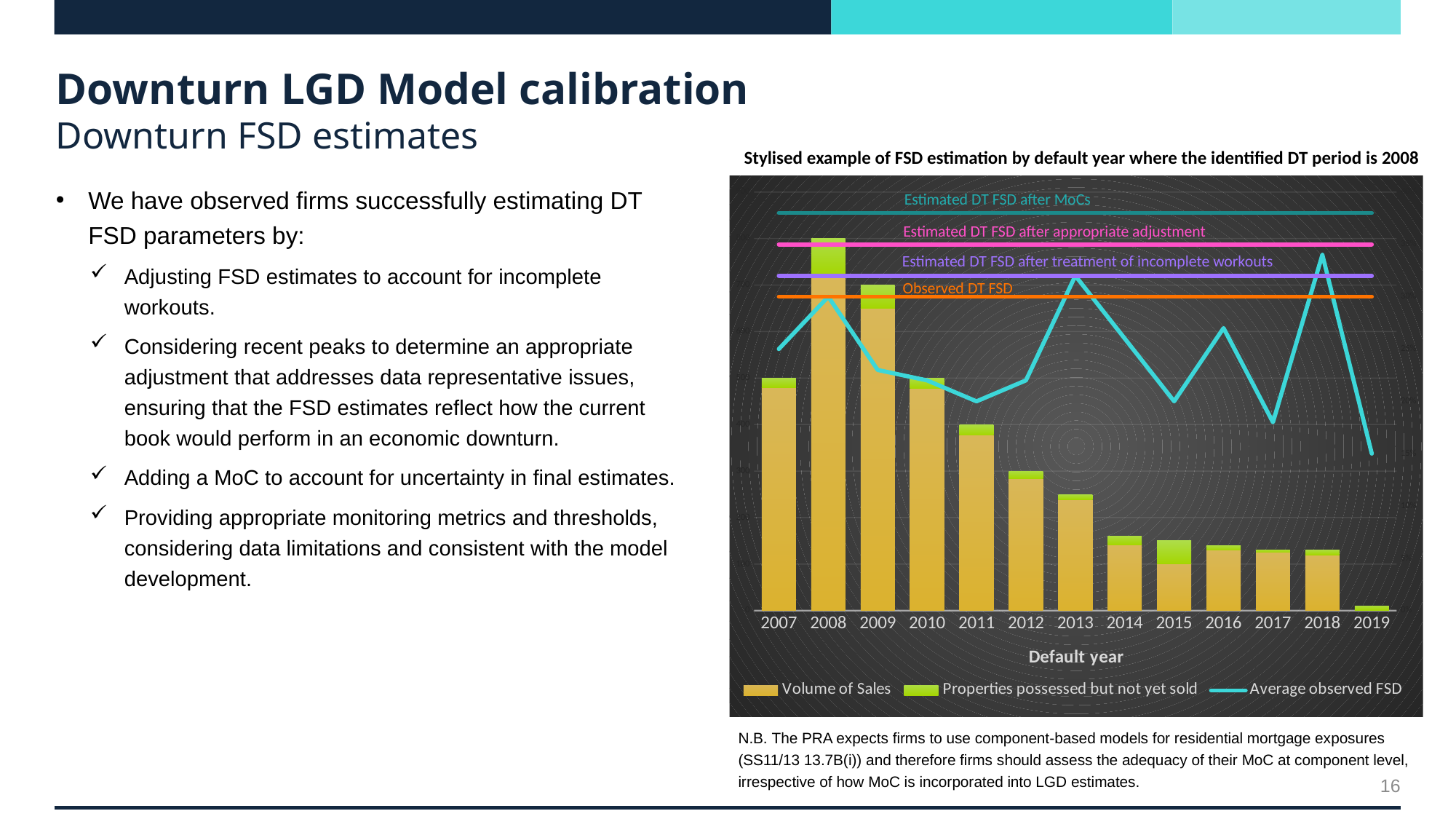
Do the bar heights generally rise or fall from 2009 to 2019? Fall What kind of chart is shown on the slide? A combination bar and line chart What is the label of the topmost horizontal line in the chart? Estimated DT FSD after MoCs How many series does the chart's legend list? 3 Which default year has the largest 'Properties possessed but not yet sold' segment? 2008 What is the label of the chart's x axis? Default year In which default year does the Average observed FSD line reach its lowest point? 2019 In which default year does the Average observed FSD line reach its highest point? 2018 How many default years are shown on the x axis of the chart? 13 Which bar is taller, 2011 or 2012? 2011 Which default year has the shortest bar in the chart? 2019 Which default year has the tallest bar in the chart? 2008